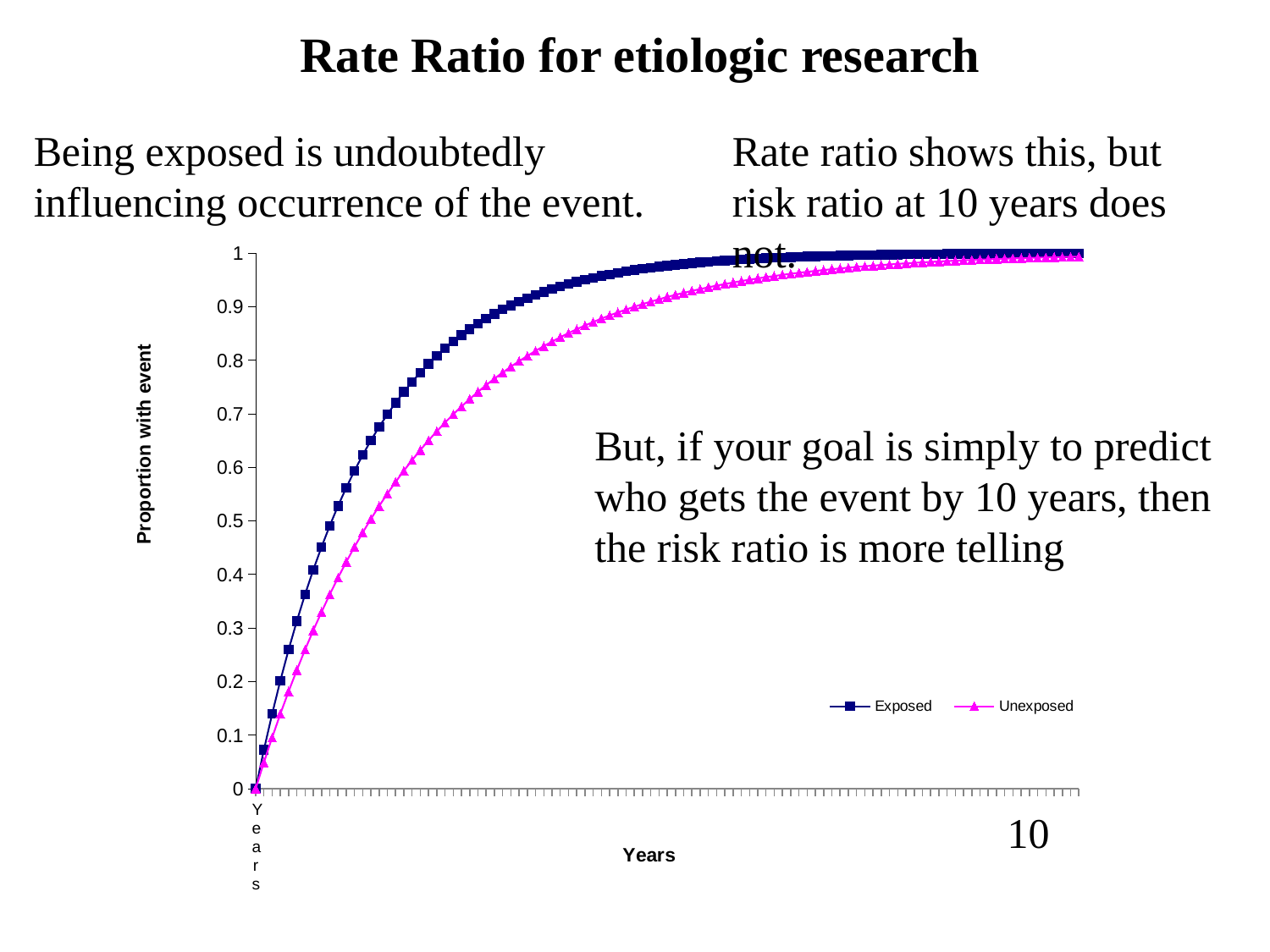
Is the proportion with event for the Exposed series at the end of follow-up greater or less than 0.9? greater What is the highest value shown on the chart's vertical axis? 1 What are the two series named in the chart's legend? Exposed and Unexposed What is the proportion with event for both series at the start of follow-up (year 0)? 0 Is the proportion with event for the Unexposed series at the end of follow-up greater or less than 0.9? greater Which series reaches a proportion with event of 0.9 sooner, Exposed or Unexposed? Exposed Does the proportion with event for the Exposed series rise or fall as years increase? rise What kind of chart is shown on the slide? line chart Which series has the higher proportion with event during the early years of follow-up, Exposed or Unexposed? Exposed What is the title of the chart's vertical axis? Proportion with event How many series does the chart's legend list? 2 Does the proportion with event for the Unexposed series rise or fall as years increase? rise